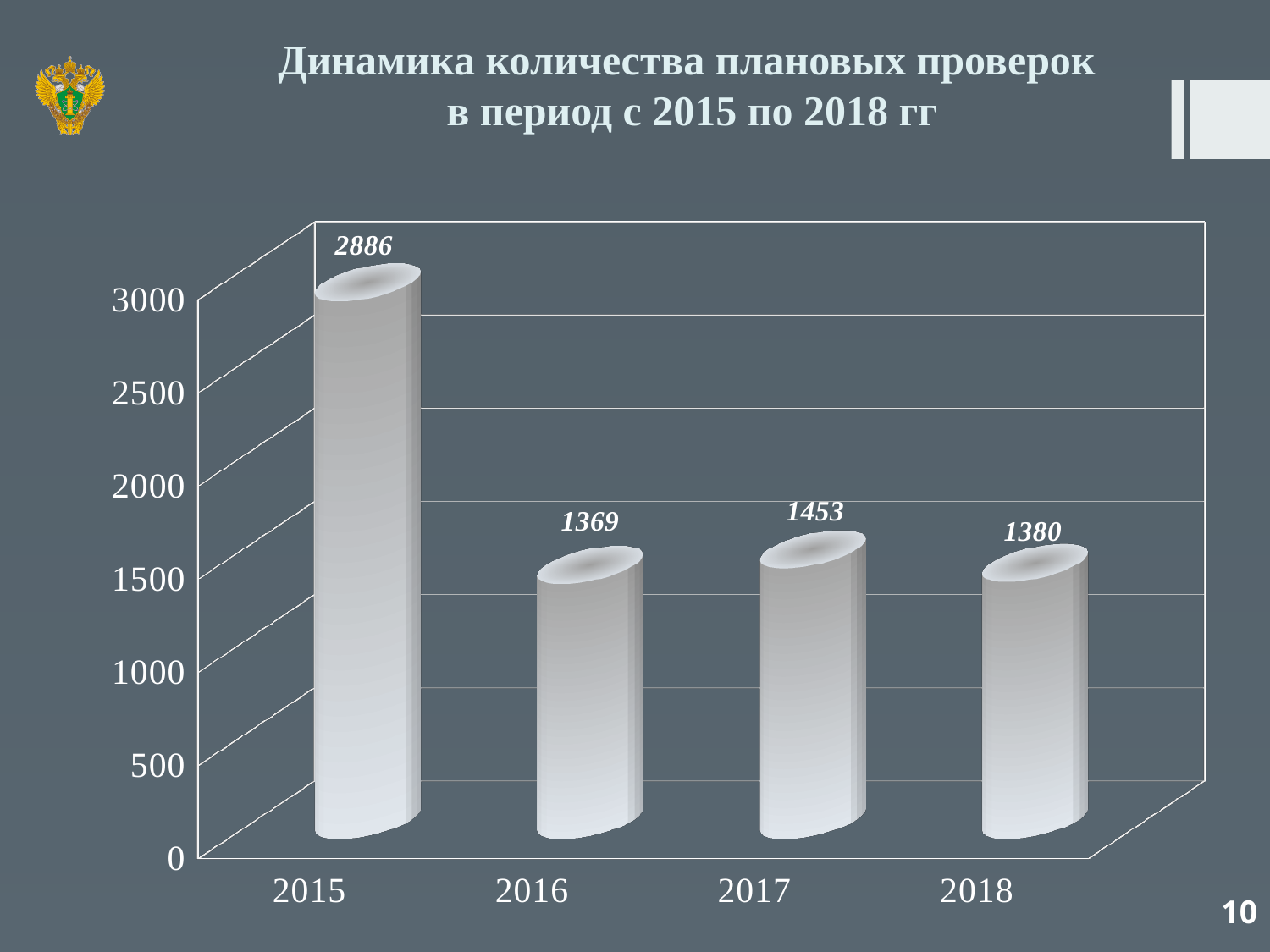
Which is larger, the value for 2017 or the value for 2018? 2017 What is the title of the chart? Динамика количества плановых проверок в период с 2015 по 2018 гг What is the value for 2017? 1453 Which year has the lowest value? 2016 What is the value for 2016? 1369 What is the difference between the values for 2015 and 2016? 1517 What is the value for 2018? 1380 What is the difference between the values for 2017 and 2018? 73 What is the value for 2015? 2886 What kind of chart is shown on the slide? bar chart Which year has the highest value? 2015 How many years are shown on the x axis? 4